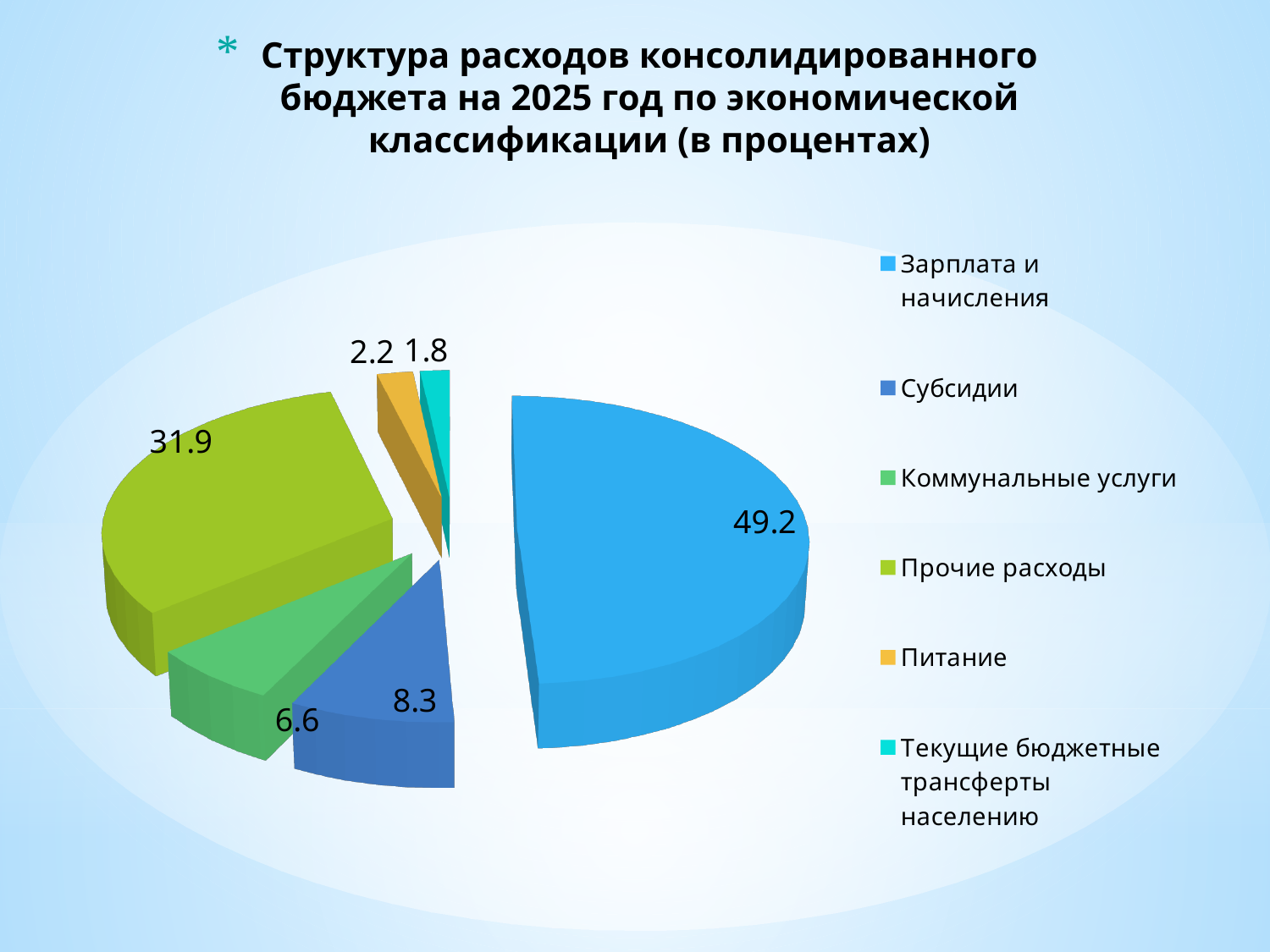
What is the value for Текущие бюджетные трансферты населению? 1.8 Which category has the largest share of the pie? Зарплата и начисления What is the value for Питание? 2.2 How many categories does the legend list? 6 Which is larger, the value for Субсидии or the value for Коммунальные услуги? Субсидии What is the value for Зарплата и начисления? 49.2 What is the value for Прочие расходы? 31.9 What is the value for Субсидии? 8.3 What is the value for Коммунальные услуги? 6.6 What type of chart is shown on the slide? Pie chart What is the difference between the values for Зарплата и начисления and Прочие расходы? 17.3 Which category has the smallest share of the pie? Текущие бюджетные трансферты населению